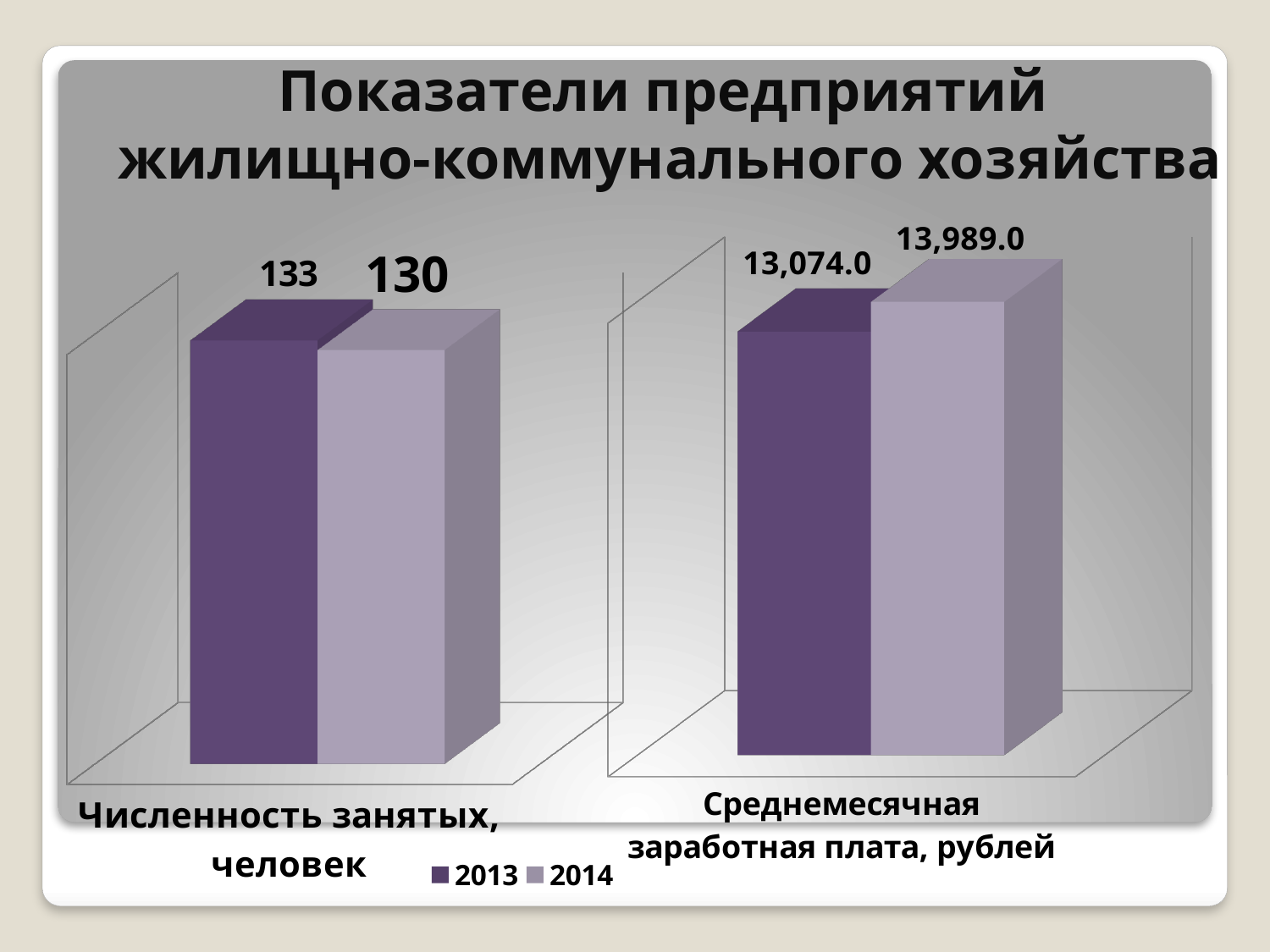
In the left chart (Численность занятых, человек), what is the value for 2014? 130 What kind of chart is used on this slide? Bar chart In the right chart (Среднемесячная заработная плата, рублей), what is the difference between the 2014 and 2013 values? 915.0 In the right chart (Среднемесячная заработная плата, рублей), which year has the higher value? 2014 In the left chart (Численность занятых, человек), what is the difference between the 2013 and 2014 values? 3 In the right chart (Среднемесячная заработная плата, рублей), what is the value for 2013? 13,074.0 What is the title of the slide? Показатели предприятий жилищно-коммунального хозяйства In the left chart (Численность занятых, человек), which year has the higher value? 2013 How many series does the legend list? 2 In the right chart (Среднемесячная заработная плата, рублей), does the value rise or fall from 2013 to 2014? Rise In the right chart (Среднемесячная заработная плата, рублей), what is the value for 2014? 13,989.0 In the left chart (Численность занятых, человек), what is the value for 2013? 133